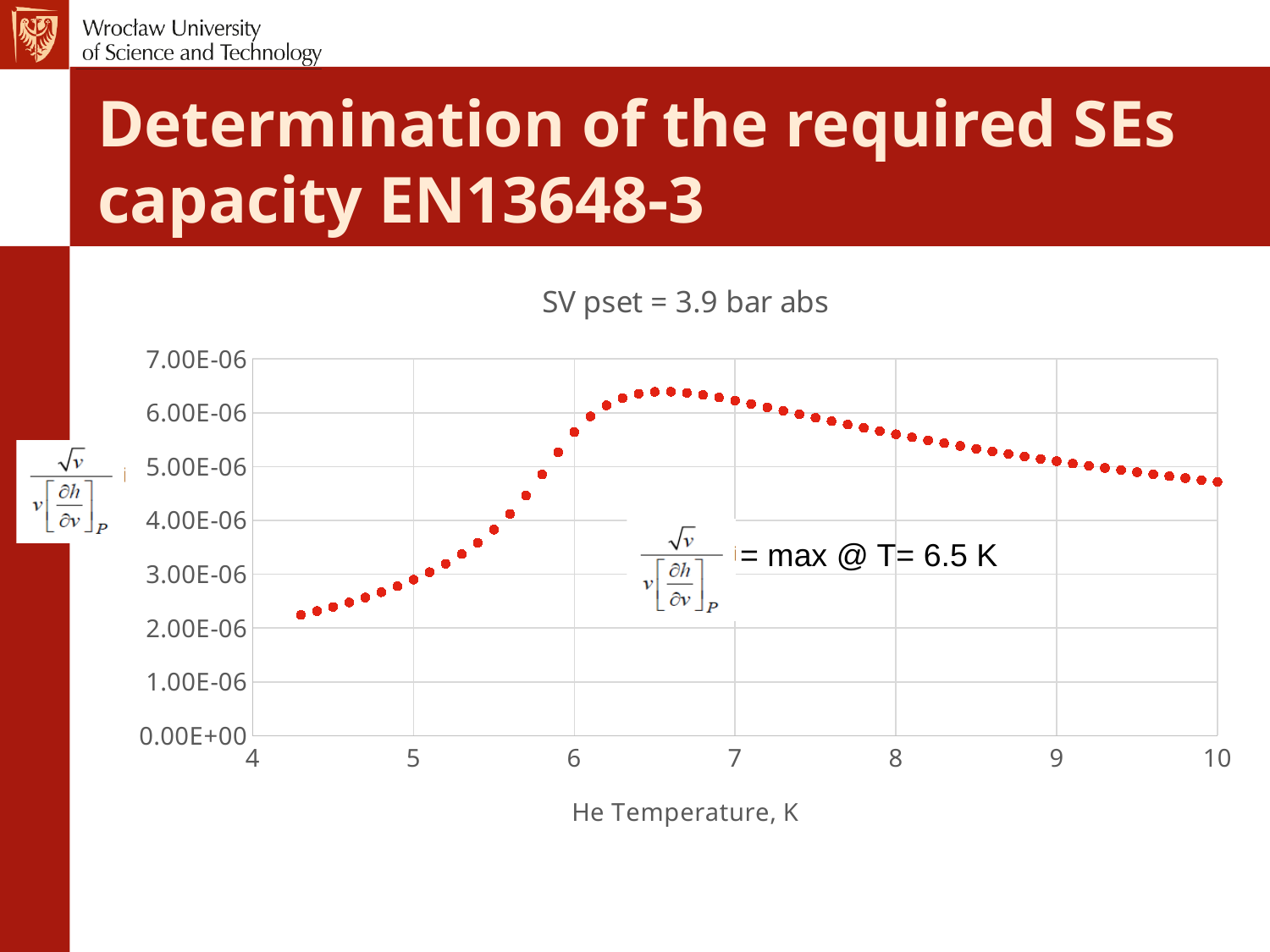
What kind of chart is shown on the slide? scatter chart At which He temperature does the plotted quantity reach its maximum, according to the annotation on the chart? 6.5 K Is the value at a He temperature of 10 K greater or less than 5.00E-06? less Do the plotted values rise or fall as the He temperature increases from 7 K to 10 K? fall Is the value at a He temperature of 8 K greater or less than 6.00E-06? less What is the label of the x axis of the chart? He Temperature, K Is the value at a He temperature of 8 K greater or less than 5.00E-06? greater Do the plotted values rise or fall as the He temperature increases from 4 K to 6.5 K? rise What is the title of the chart? SV pset = 3.9 bar abs